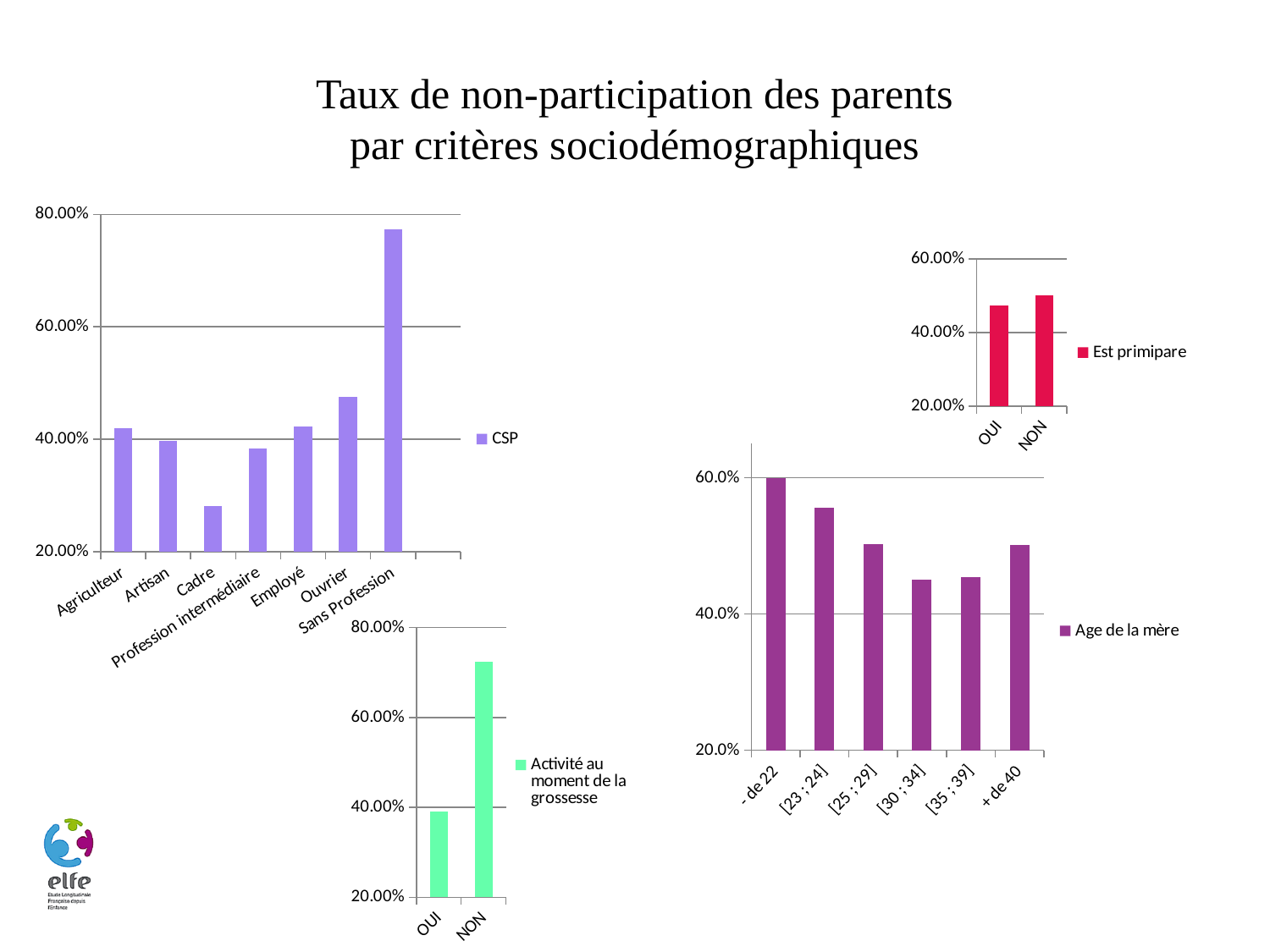
What kind of chart is the chart with the legend 'Est primipare'? bar chart In the chart with the legend 'CSP', is the value for Sans Profession greater or less than 60.00%? greater In the chart with the legend 'CSP', is the value for Cadre greater or less than 40.00%? less In the chart with the legend 'Est primipare', is the value for OUI greater or less than 40.00%? greater In the chart with the legend 'Age de la mère', do the values rise or fall from '- de 22' to '[30 ; 34]'? fall In the chart with the legend 'Age de la mère', which category has the highest value? - de 22 In the chart with the legend 'CSP', which category has the lowest value? Cadre In the chart with the legend 'Activité au moment de la grossesse', which category has the larger value, OUI or NON? NON How many categories are shown in the chart with the legend 'Age de la mère'? 6 In the chart with the legend 'CSP', which category has the highest value? Sans Profession How many categories are shown in the chart with the legend 'CSP'? 7